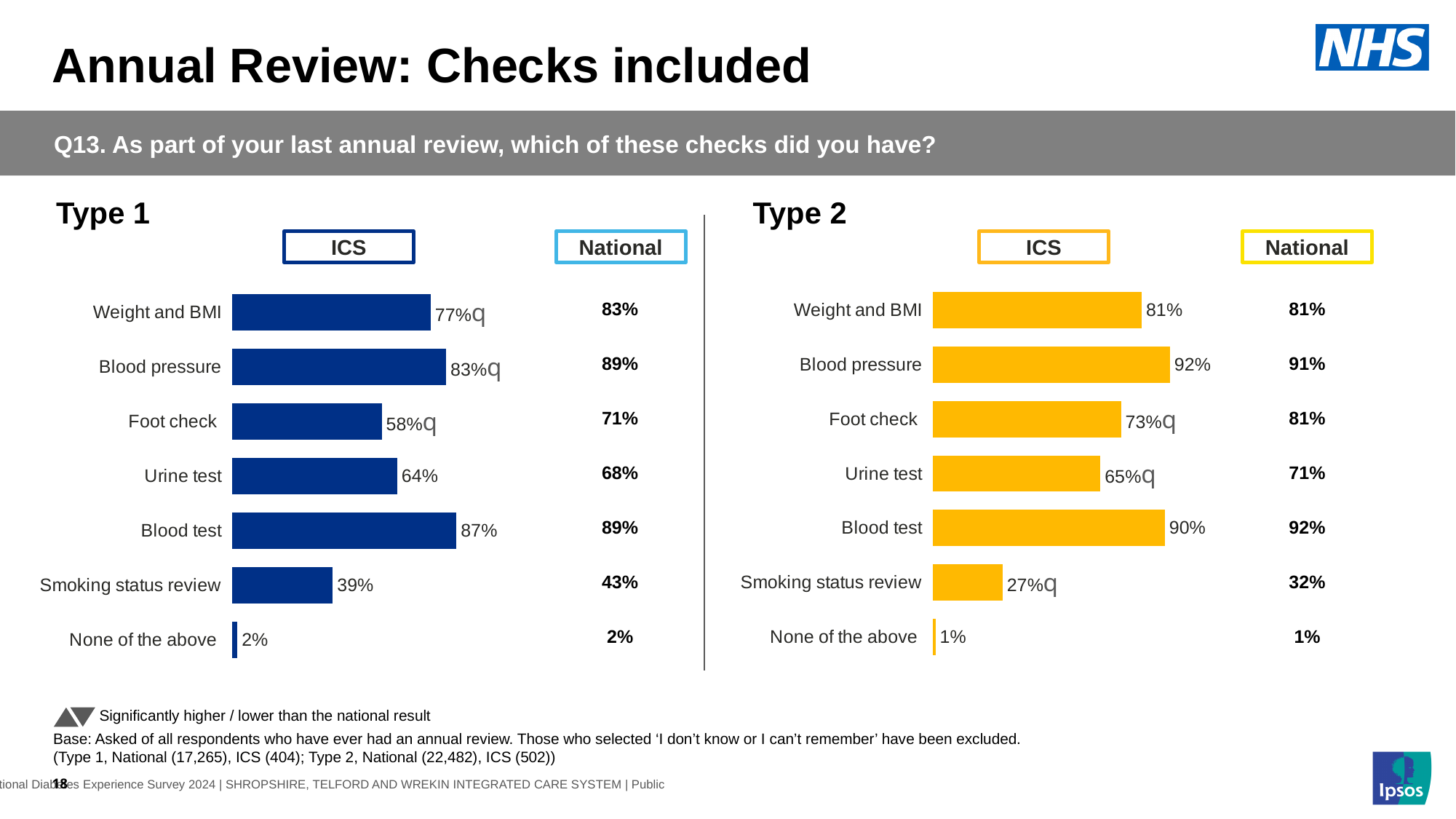
What kind of chart is used for the Type 2 ICS results? Bar chart On the Type 2 chart, what is the ICS value for Foot check? 73% How many checks are listed on the Type 1 chart? 7 On the Type 2 chart, which check has the lowest ICS value? None of the above On the Type 2 chart, what is the difference between the ICS and National values for Smoking status review? 5 percentage points On the Type 1 chart, what is the difference between the National and ICS values for Foot check? 13 percentage points On the Type 1 chart, what is the ICS value for Blood pressure? 83% On the Type 1 chart, which is larger for Urine test: the ICS value or the National value? National On the Type 2 chart, which is larger for Blood pressure: the ICS value or the National value? ICS On the Type 1 chart, what is the National value for Foot check? 71% On the Type 2 chart, what is the National value for Smoking status review? 32% On the Type 1 chart, which check has the highest ICS value? Blood test